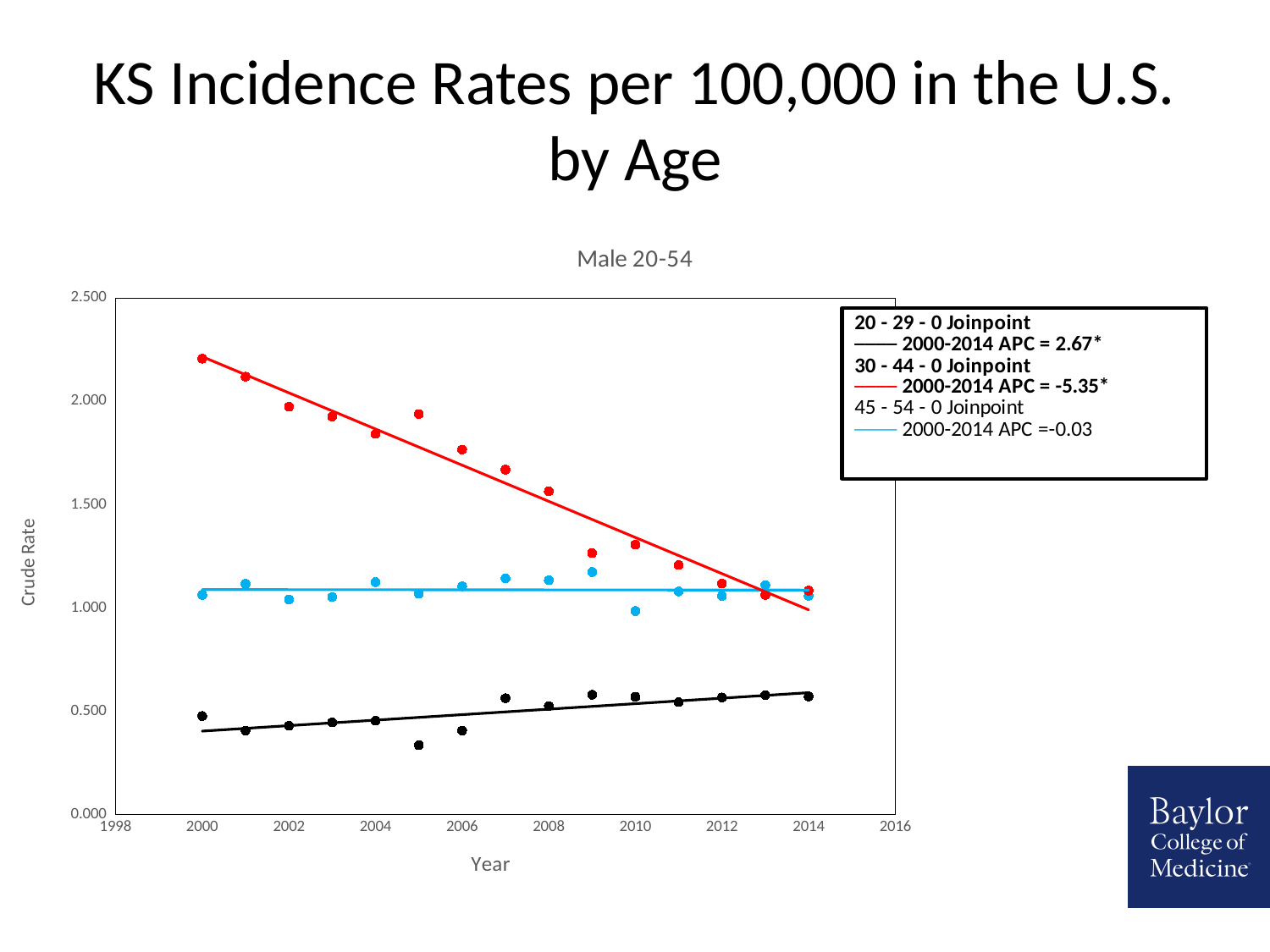
How many age-group series does the legend list? 3 In 2014, which age group has the higher crude rate: 45 - 54 or 20 - 29? 45 - 54 In 2000, which age group has the higher crude rate: 30 - 44 or 20 - 29? 30 - 44 Is the crude rate for the 30 - 44 age group in 2000 greater or less than 2.000? greater Is the crude rate for the 20 - 29 age group in 2005 greater or less than 0.500? less Do the values for the 30 - 44 age group (red) rise or fall from 2000 to 2014? Fall Is the crude rate for the 30 - 44 age group in 2010 greater or less than 1.500? less What is the 2000-2014 APC shown in the legend for the 20 - 29 age group? 2.67* What kind of chart is shown on the slide? Scatter chart with trend lines What is the 2000-2014 APC shown in the legend for the 30 - 44 age group? -5.35* How many years of data points are plotted for each age group? 15 Do the values for the 20 - 29 age group (black) rise or fall from 2000 to 2014? Rise